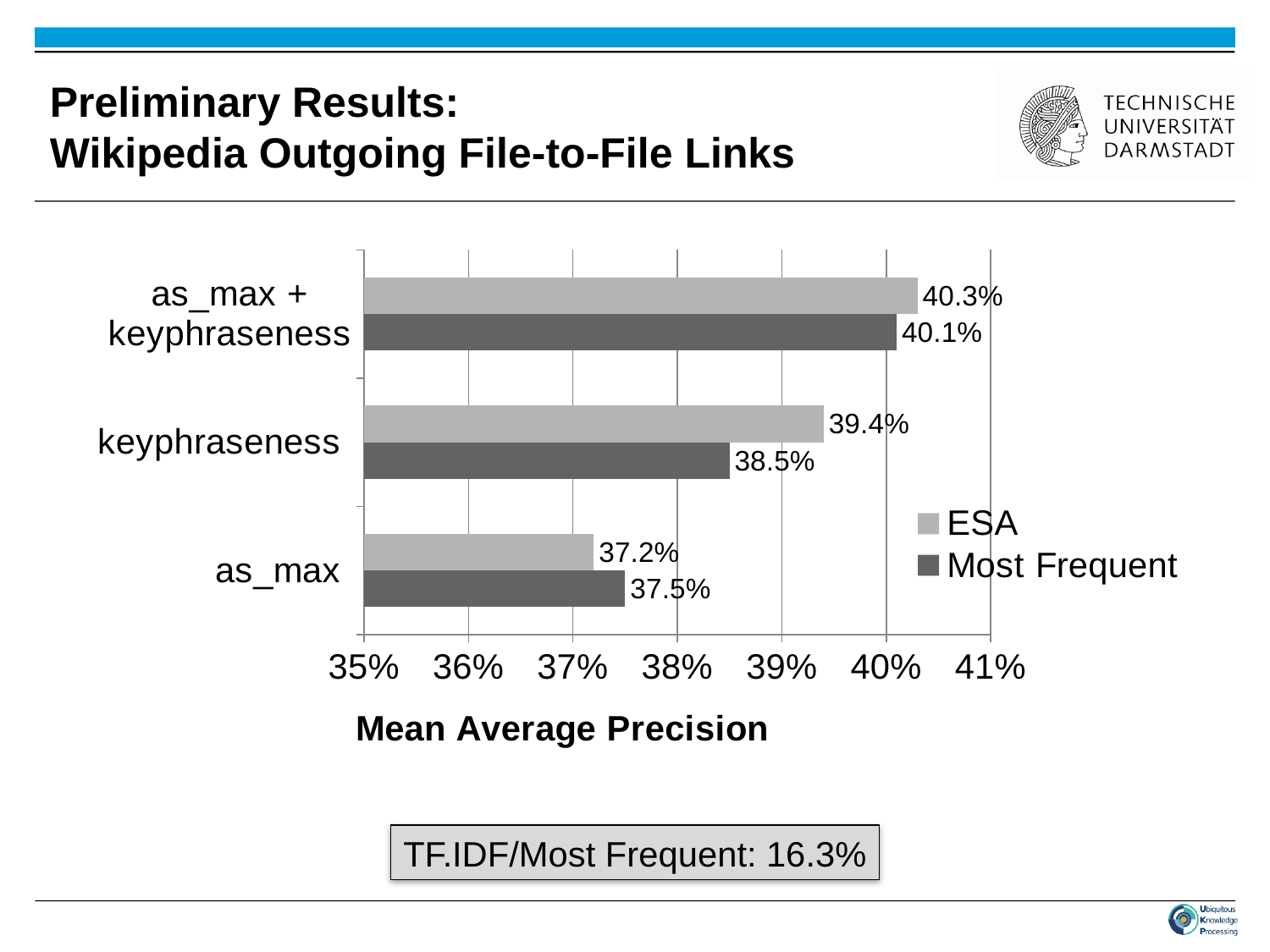
What is the ESA value for as_max + keyphraseness? 40.3% What is the Most Frequent value for keyphraseness? 38.5% How many series does the legend list? 2 Which category has the lowest Most Frequent value? as_max Is the ESA value for keyphraseness greater or less than 39%? greater What is the difference between the ESA and Most Frequent values for keyphraseness? 0.9% What is the Most Frequent value for as_max? 37.5% What is the label of the horizontal axis? Mean Average Precision What kind of chart is shown on the slide? bar chart Which category has the highest ESA value? as_max + keyphraseness For as_max, which is larger: the ESA value or the Most Frequent value? Most Frequent How many categories are shown on the chart? 3